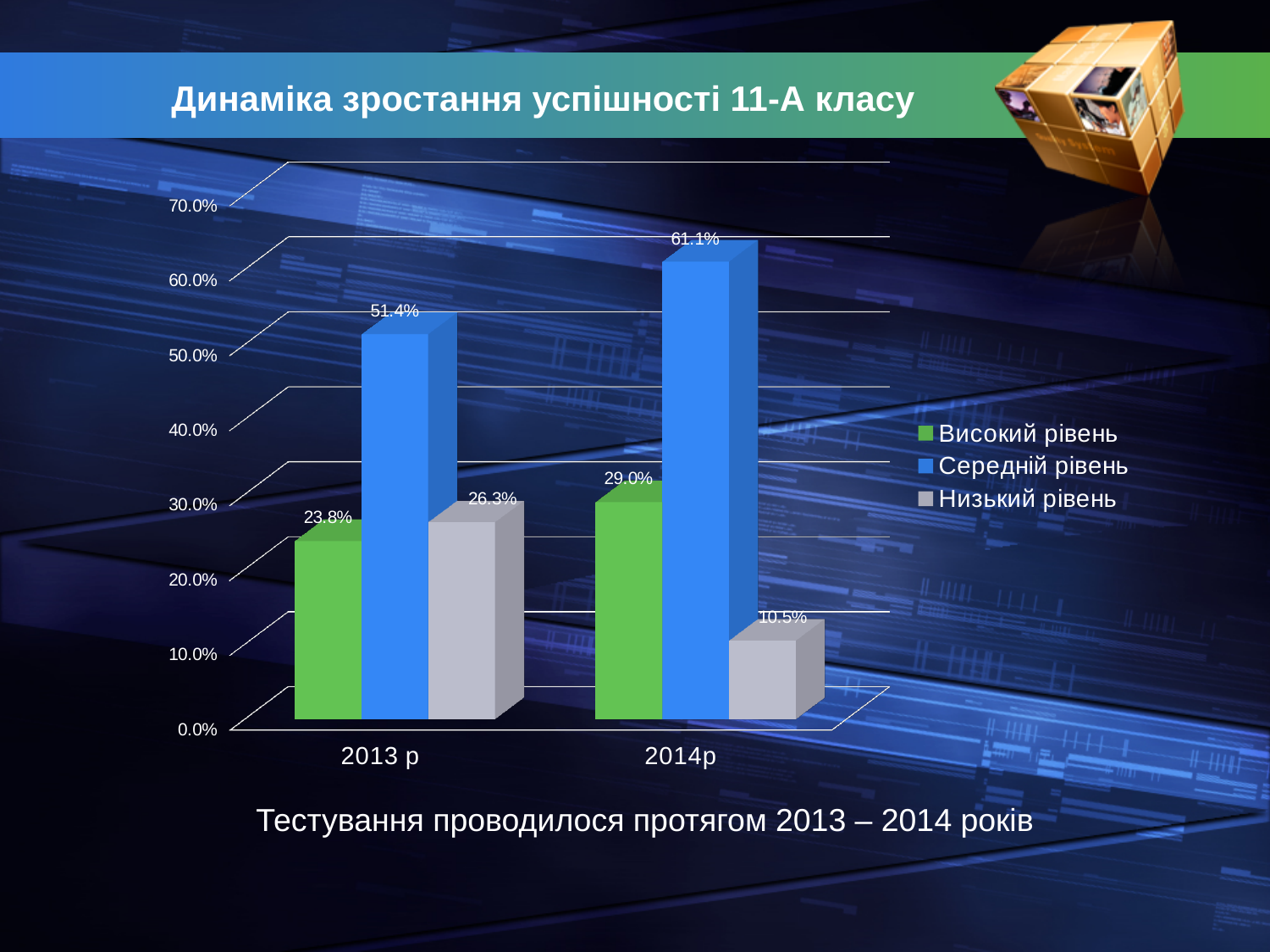
What is the difference between the Середній рівень values for 2014р and 2013 р? 9.7% What is the value for Низький рівень in 2014р? 10.5% What is the value for Низький рівень in 2013 р? 26.3% What is the value for Високий рівень in 2013 р? 23.8% Which is larger: Високий рівень in 2013 р or Високий рівень in 2014р? Високий рівень in 2014р Which series has the lowest value in 2014р? Низький рівень What kind of chart is shown on the slide? Bar chart Which series has the highest value in 2014р? Середній рівень How many categories are shown on the x axis? 2 How many series does the legend list? 3 Does the value for Низький рівень rise or fall from 2013 р to 2014р? Fall What is the value for Середній рівень in 2014р? 61.1%